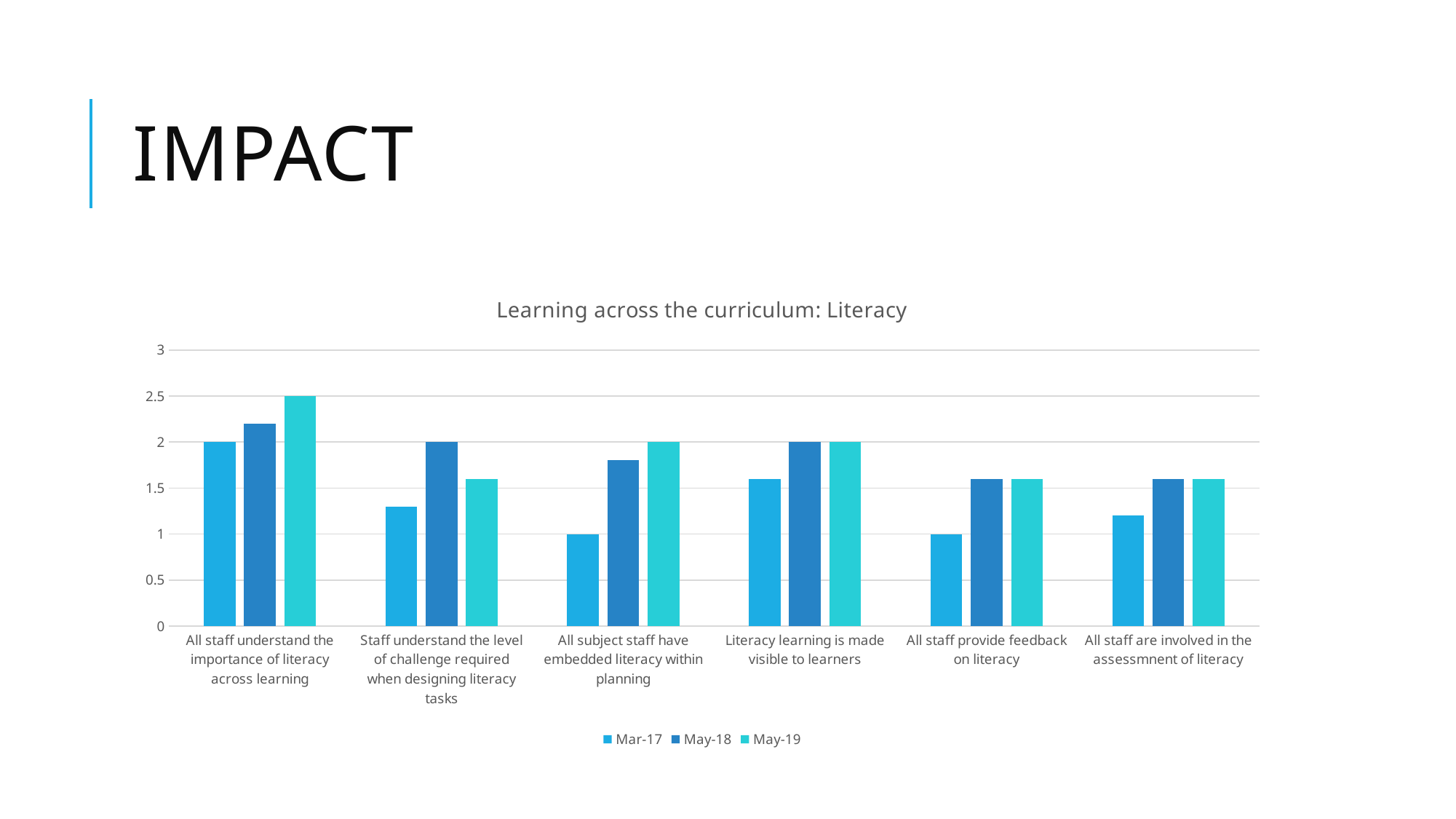
How many series does the legend list? 3 What is the title of the chart? Learning across the curriculum: Literacy What is the May-18 value for 'Staff understand the level of challenge required when designing literacy tasks'? 2 Is the Mar-17 value for 'All staff are involved in the assessmnent of literacy' greater or less than 1.5? less What is the difference between the May-19 and Mar-17 values for 'All subject staff have embedded literacy within planning'? 1 How many categories are shown on the x axis? 6 What type of chart is shown on the slide? bar chart Is the May-18 value for 'All subject staff have embedded literacy within planning' greater or less than 1.5? greater Which category has the highest May-19 value? All staff understand the importance of literacy across learning What is the May-19 value for 'All staff understand the importance of literacy across learning'? 2.5 For 'Staff understand the level of challenge required when designing literacy tasks', which is larger: the May-18 value or the May-19 value? May-18 What is the Mar-17 value for 'All subject staff have embedded literacy within planning'? 1